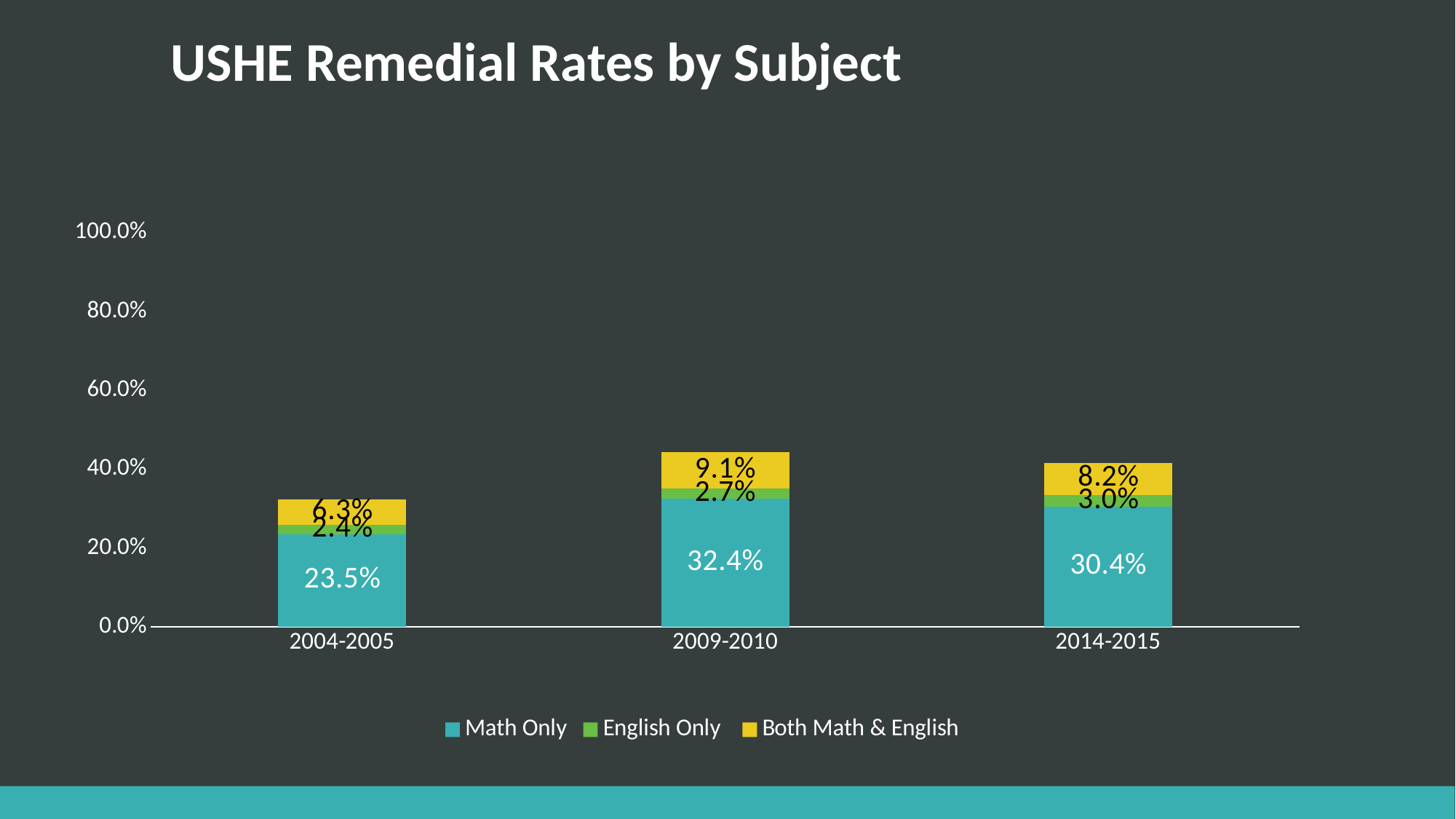
Which year has the highest Math Only value? 2009-2010 What is the English Only value for 2014-2015? 3.0% Is the Both Math & English value larger for 2009-2010 or 2014-2015? 2009-2010 Which year has the lowest Both Math & English value? 2004-2005 How many year categories are shown on the x axis? 3 How many series does the legend list? 3 What is the Both Math & English value for 2004-2005? 6.3% What kind of chart is shown on the slide? Stacked bar chart What is the difference between the Math Only values for 2009-2010 and 2004-2005? 8.9% What is the total of the stacked bar for 2009-2010? 44.2% What is the total of the stacked bar for 2004-2005? 32.2% What is the Math Only value for 2009-2010? 32.4%